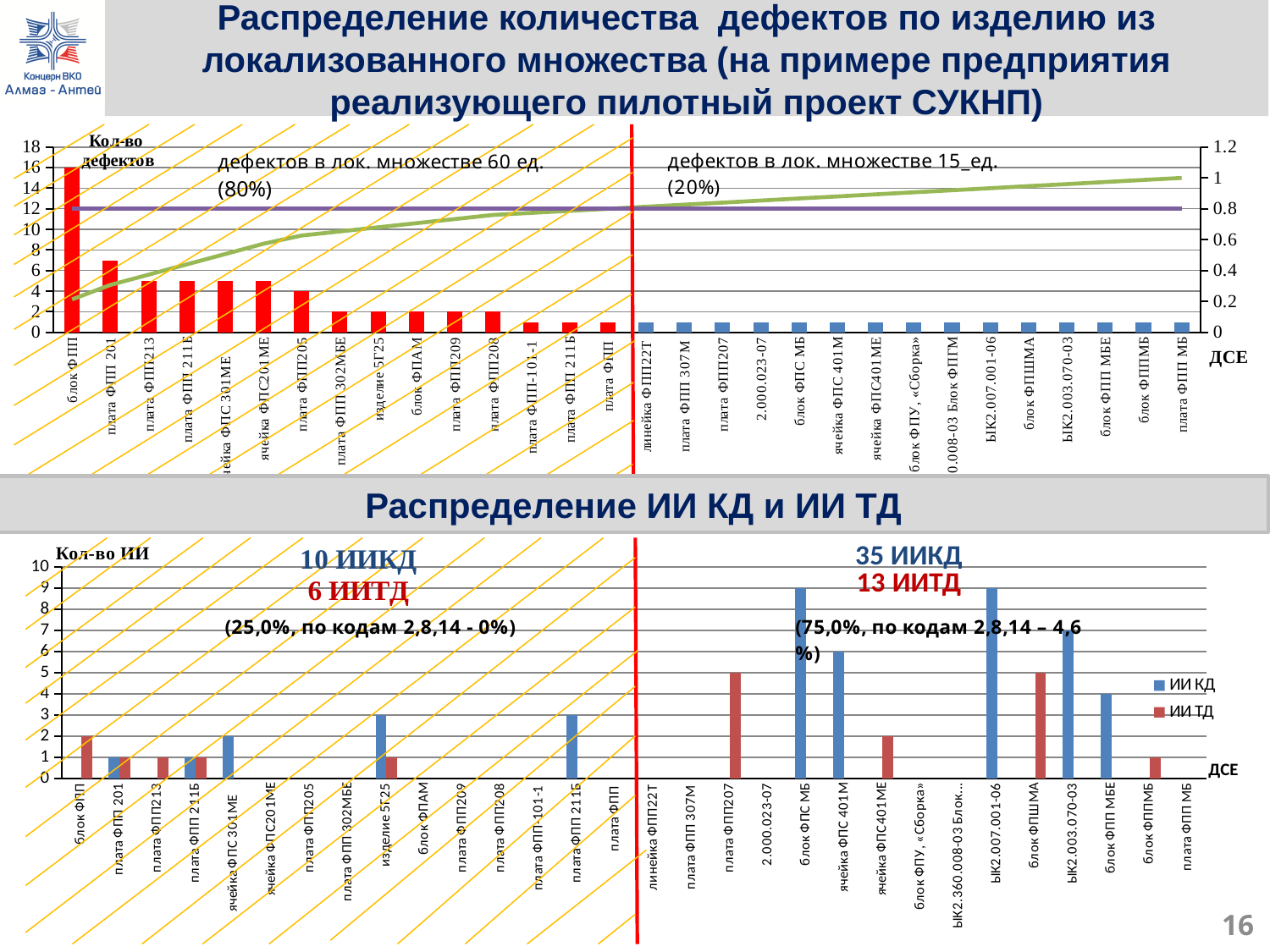
In the bottom chart, which has the larger ИИ КД value: ячейка ФПС 401М or блок ФПП МБЕ? ячейка ФПС 401М In the bottom chart, what is the ИИ ТД value for плата ФПП207? 5 In the top chart, is the number of defects for блок ФПП greater or less than 14? greater In the bottom chart (Распределение ИИ КД и ИИ ТД), how many series does the legend list? 2 In the bottom chart, what is the ИИ КД value for блок ФПС МБ? 9 In the bottom chart, what is the ИИ ТД value for блок ФПП? 2 In the bottom chart, what is the difference between the ИИ КД values for блок ФПС МБ and ячейка ФПС 401М? 3 In the top chart, which item has the highest number of defects? блок ФПП In the top chart, what does the annotation on the left side of the red line say about the number of defects in the localized set? дефектов в лок. множестве 60 ед. (80%) In the bottom chart, what is the ИИ КД value for ЫК2.003.070-03? 7 In the top chart, is the number of defects for плата ФПП 201 greater or less than 6? greater In the top chart (Распределение количества дефектов по изделию), what kind of chart is used to show the number of defects per item? bar chart